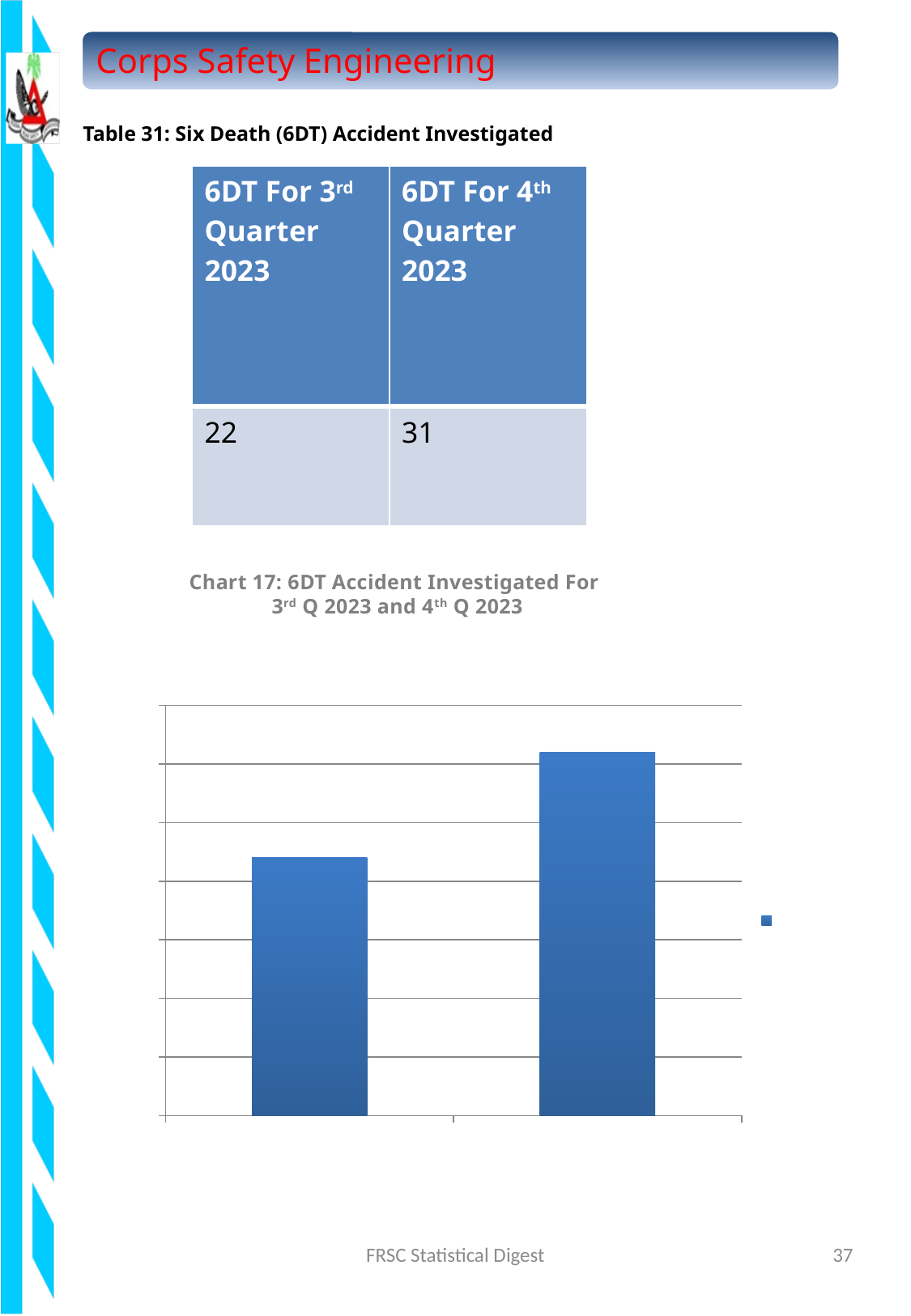
How many bars are plotted in Chart 17? 2 In Chart 17, which bar is the lowest, the left bar or the right bar? the left bar What kind of chart is Chart 17? bar chart In Chart 17, do the bar values rise or fall from left to right? rise What is the title of the chart on the slide? Chart 17: 6DT Accident Investigated For 3rd Q 2023 and 4th Q 2023 In Chart 17, which bar is taller, the left bar or the right bar? the right bar What colour are the bars in Chart 17? blue In Chart 17, which bar is the highest, the left bar or the right bar? the right bar